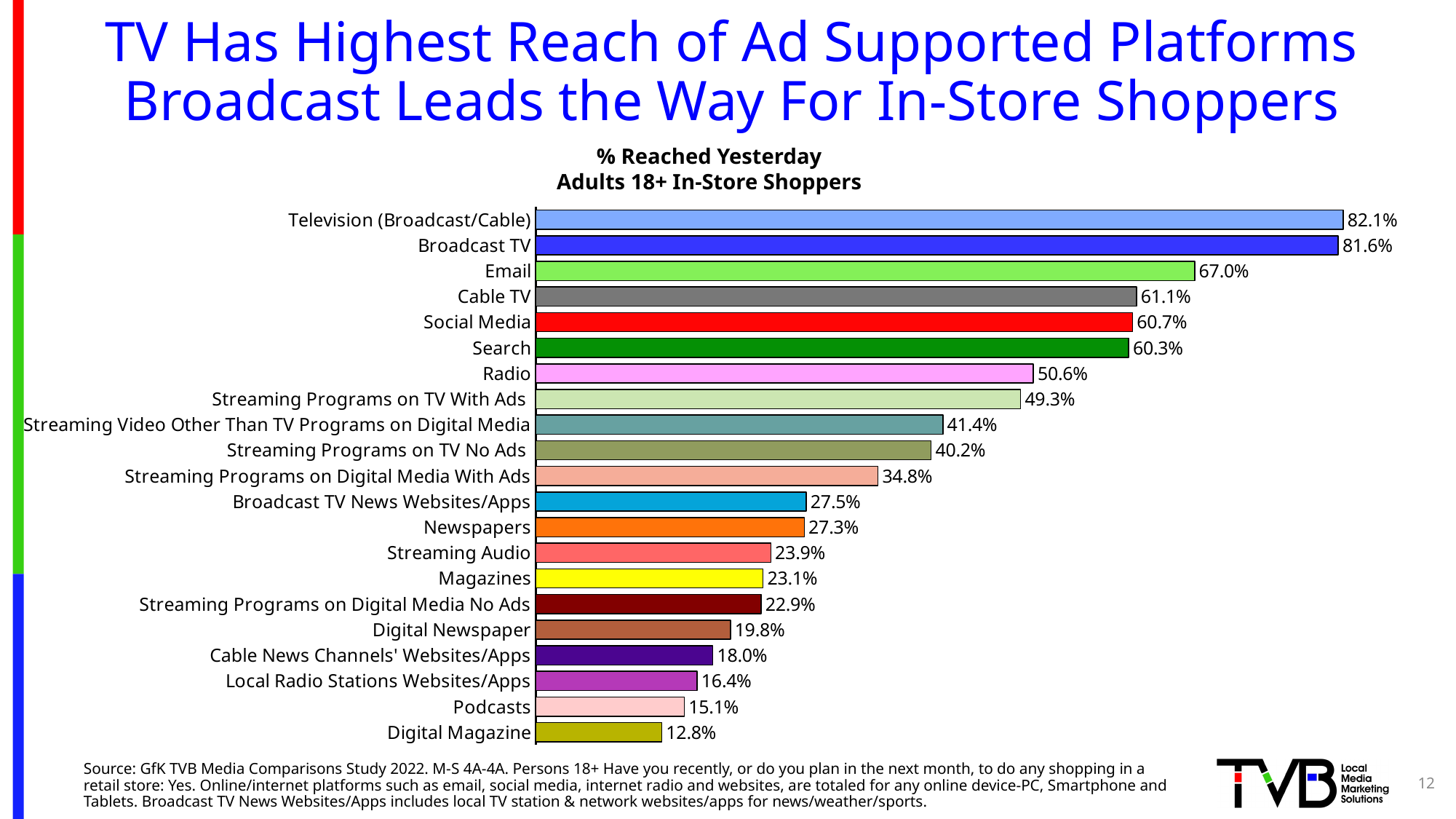
Which is larger, the value for Newspapers or the value for Magazines? Newspapers What is the value for Podcasts? 15.1% What is the title of the chart? % Reached Yesterday Adults 18+ In-Store Shoppers What kind of chart is shown on the slide? Bar chart How many categories are shown in the chart? 21 What is the value for Email? 67.0% Which category has the highest value? Television (Broadcast/Cable) Which category has the lowest value? Digital Magazine What is the value for Radio? 50.6% What is the difference between the values for Email and Cable TV? 5.9% What is the difference between the values for Television (Broadcast/Cable) and Broadcast TV? 0.5% Which is larger, the value for Streaming Programs on TV With Ads or the value for Streaming Programs on TV No Ads? Streaming Programs on TV With Ads